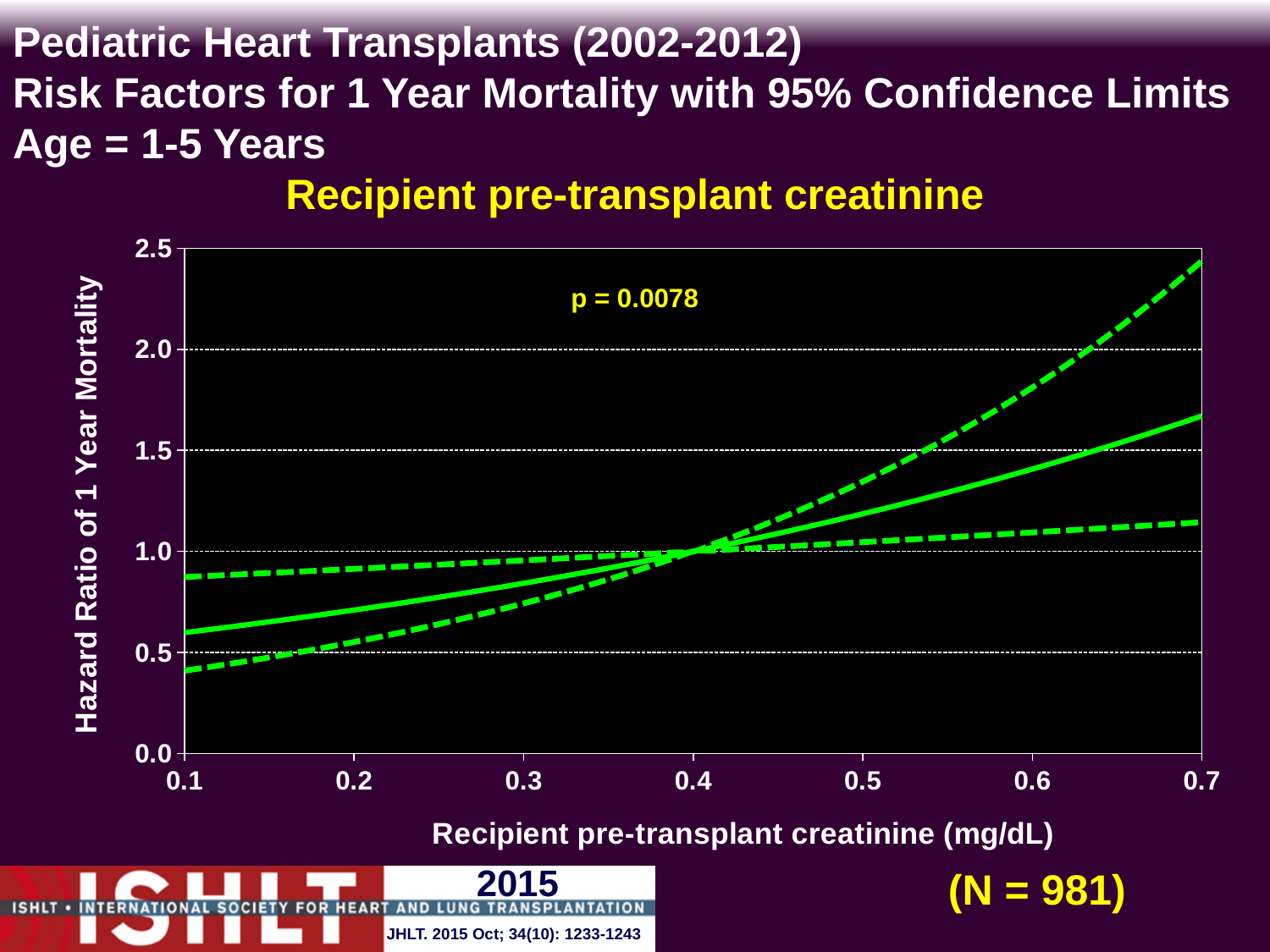
Is the hazard ratio on the solid line at a creatinine of 0.1 mg/dL greater or less than 0.5? greater Is the hazard ratio on the solid line at a creatinine of 0.7 mg/dL greater or less than 1.5? greater Does the solid hazard ratio line rise or fall as recipient pre-transplant creatinine increases from 0.1 to 0.7 mg/dL? rise Is the upper dashed confidence limit at a creatinine of 0.1 mg/dL greater or less than 1.0? less What is the p-value shown on the chart? p = 0.0078 What is the highest value shown on the y axis of the chart? 2.5 What kind of chart is shown on the slide? line chart What is the sample size (N) shown on the slide? N = 981 How many lines are plotted on the chart? 3 What is the label of the x axis? Recipient pre-transplant creatinine (mg/dL)